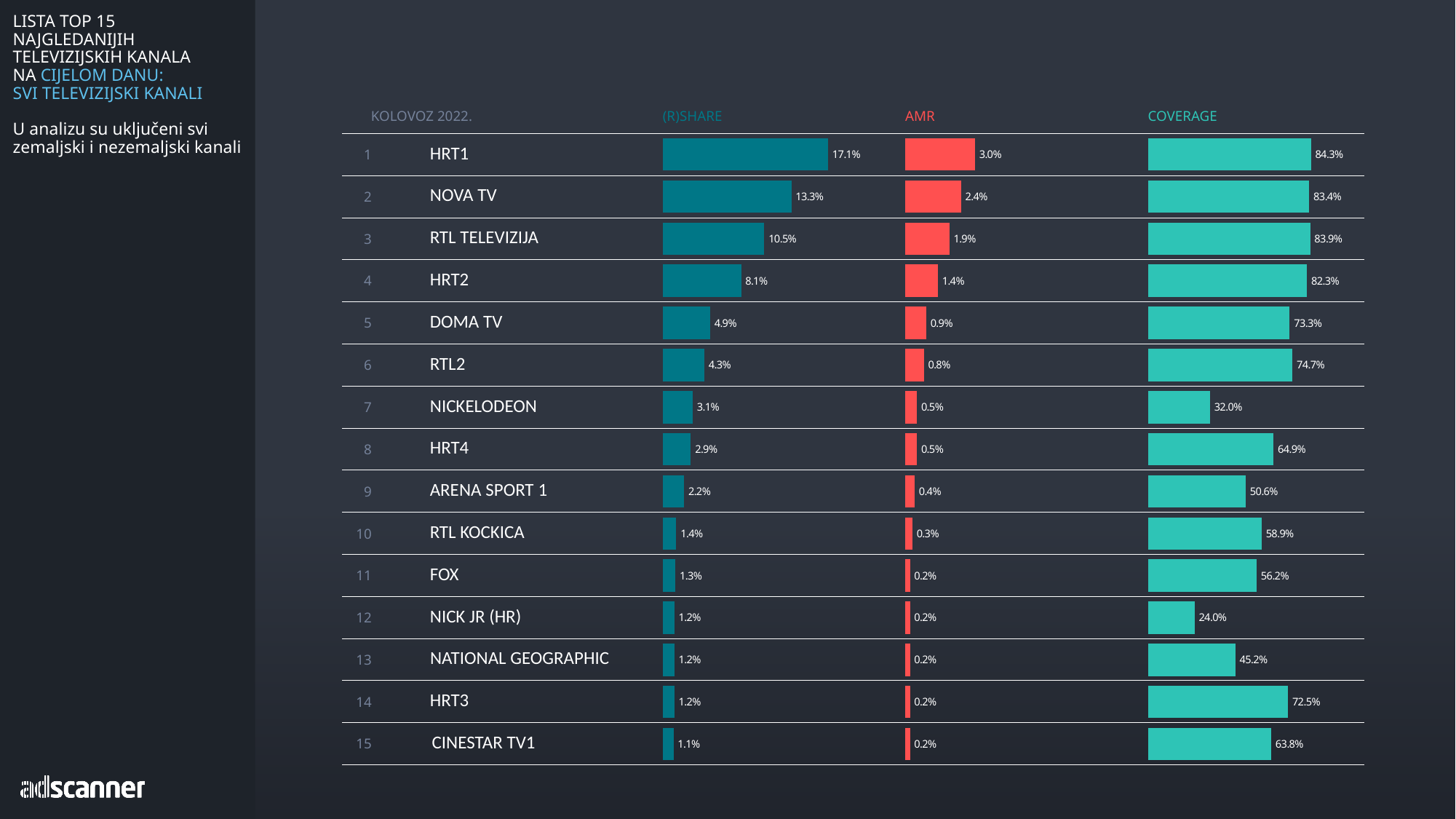
Which channel has the lowest (R)SHARE value? CINESTAR TV1 What is the COVERAGE value for NICKELODEON? 32.0% What is the AMR value for NOVA TV? 2.4% What kind of chart is used to show the (R)SHARE, AMR and COVERAGE values? Bar chart Which channel has the highest COVERAGE value? HRT1 What is the difference in (R)SHARE between HRT1 and NOVA TV? 3.8% Which has a larger COVERAGE value, RTL2 or DOMA TV? RTL2 What is the difference in COVERAGE between HRT3 and NATIONAL GEOGRAPHIC? 27.3% How many channels are listed in the chart? 15 Which month and year does the chart cover, as shown in the header? KOLOVOZ 2022. Which channel has the lowest COVERAGE value? NICK JR (HR) What is the (R)SHARE value for HRT1? 17.1%